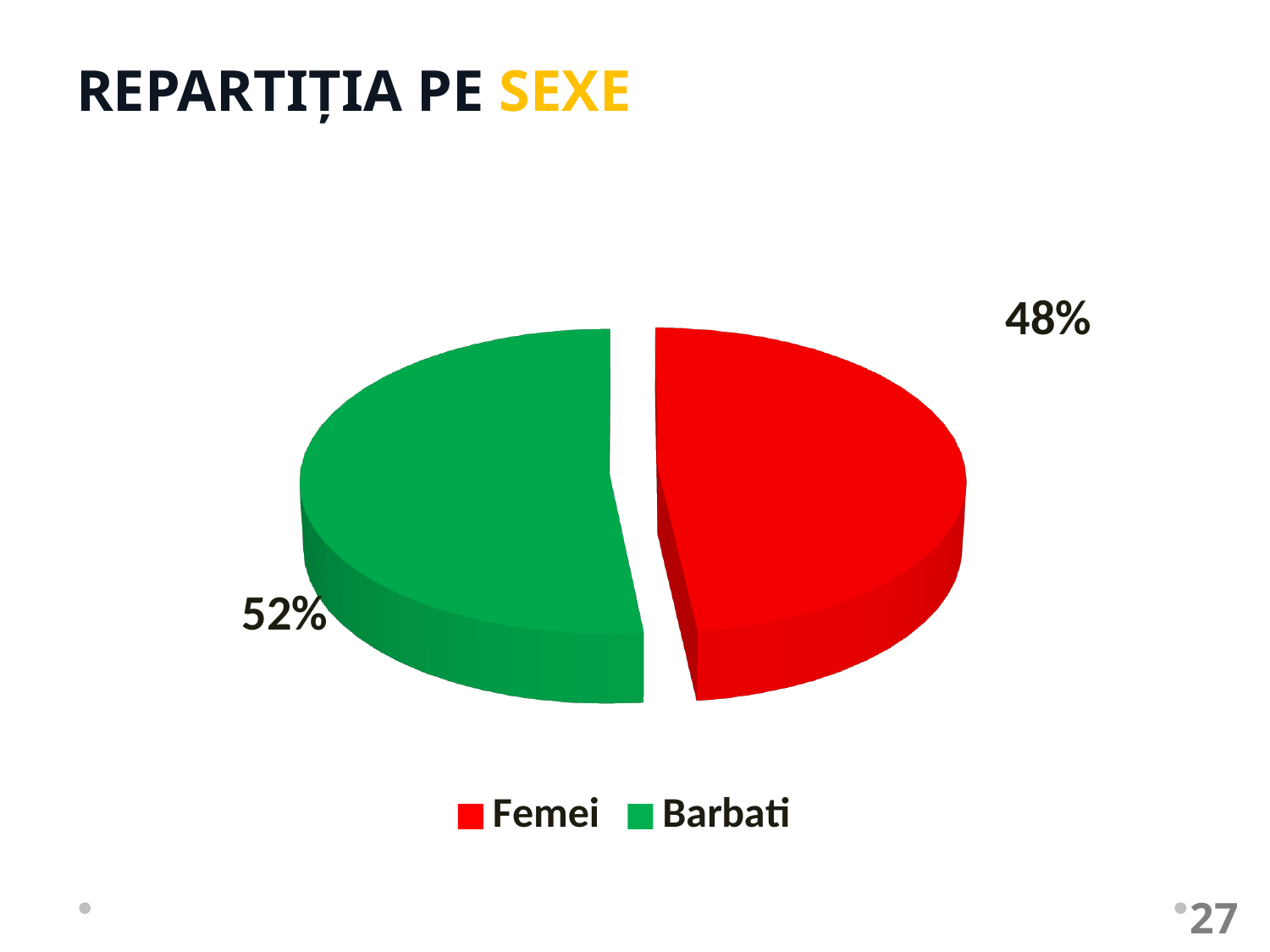
What is the title of the slide? REPARTIȚIA PE SEXE Which category has the smallest share of the pie chart? Femei What percentage of the pie chart is Femei? 48% What is the difference in percentage points between Barbati and Femei? 4 Which category has the largest share of the pie chart? Barbati What kind of chart is shown on the slide? Pie chart What percentage of the pie chart is Barbati? 52% What colour represents Femei in the pie chart? Red How many categories does the pie chart show? 2 Which is larger, the share for Femei or the share for Barbati? Barbati How many entries does the legend list? 2